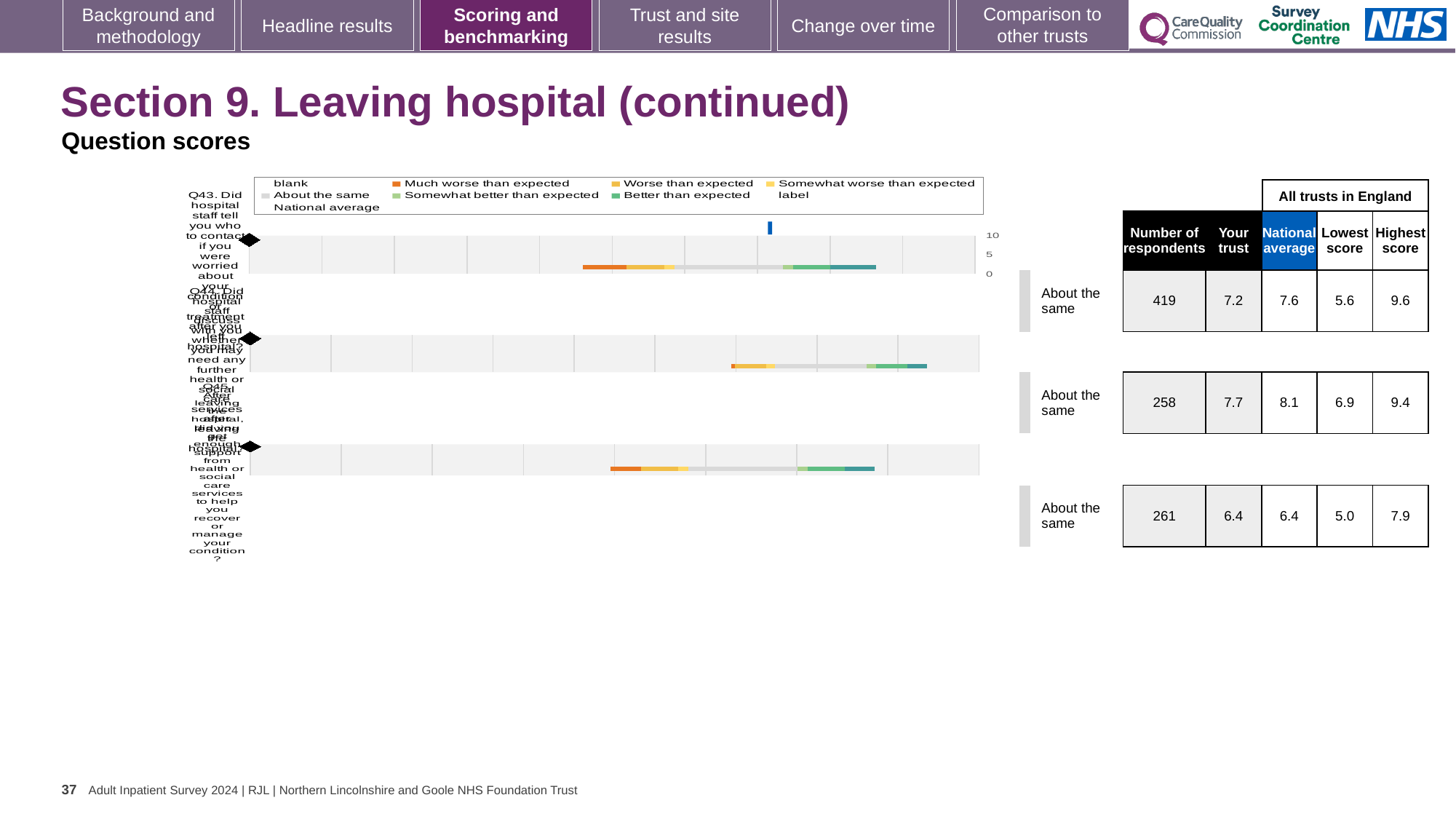
Which question has the highest 'Your trust' score? Q44 What kind of chart is shown on the slide? bar chart For Q43, which is larger: the 'Your trust' score or the national average? National average For Q45, what is the difference between the highest score and the lowest score among all trusts in England? 2.9 How many respondents are shown for Q45? 261 For Q44, what is the difference between the national average and the 'Your trust' score? 0.4 Which question has the lowest 'Your trust' score? Q45 Is the 'Your trust' score for Q43 greater or less than 5? greater What is the 'Your trust' score for Q43? 7.2 What benchmark category is shown for all three questions on the slide? About the same What is the highest score among all trusts in England for Q43? 9.6 How many questions (rows) are plotted in the chart? 3